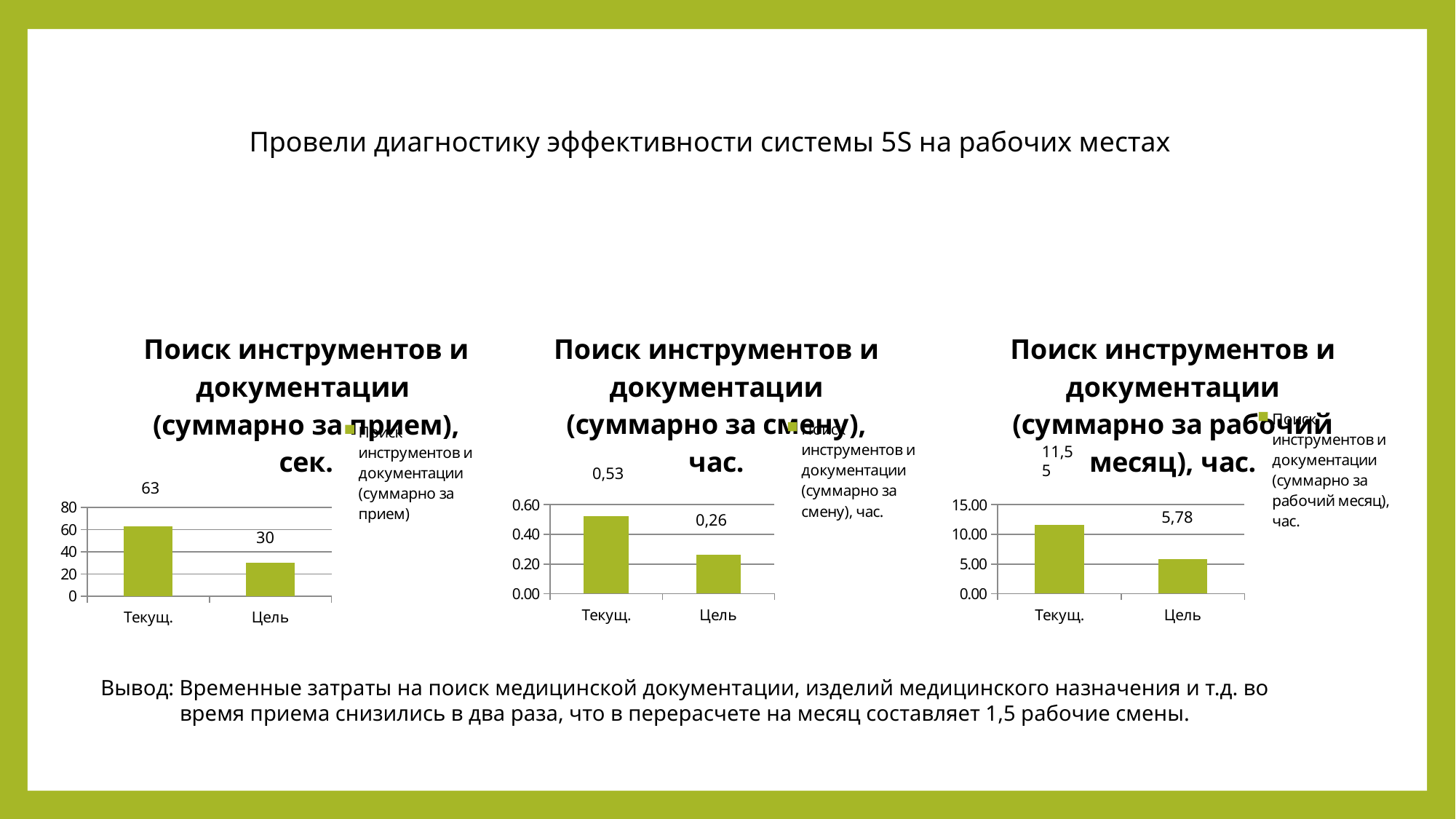
In the left chart (суммарно за прием, сек.), what is the value for Цель? 30 In the middle chart (суммарно за смену, час.), what is the value for Текущ.? 0,53 How many categories are shown in the left chart (суммарно за прием, сек.)? 2 In the right chart (суммарно за рабочий месяц, час.), which category has the lowest value? Цель In the left chart (суммарно за прием, сек.), what is the difference between Текущ. and Цель? 33 In the middle chart (суммарно за смену, час.), what is the value for Цель? 0,26 What kind of chart is the middle chart (суммарно за смену, час.)? bar chart In the middle chart (суммарно за смену, час.), which category has the higher value? Текущ. In the right chart (суммарно за рабочий месяц, час.), is the value for Текущ. greater or less than 10.00? greater In the left chart (суммарно за прием, сек.), what is the value for Текущ.? 63 In the right chart (суммарно за рабочий месяц, час.), what is the value for Текущ.? 11,55 In the right chart (суммарно за рабочий месяц, час.), what is the value for Цель? 5,78